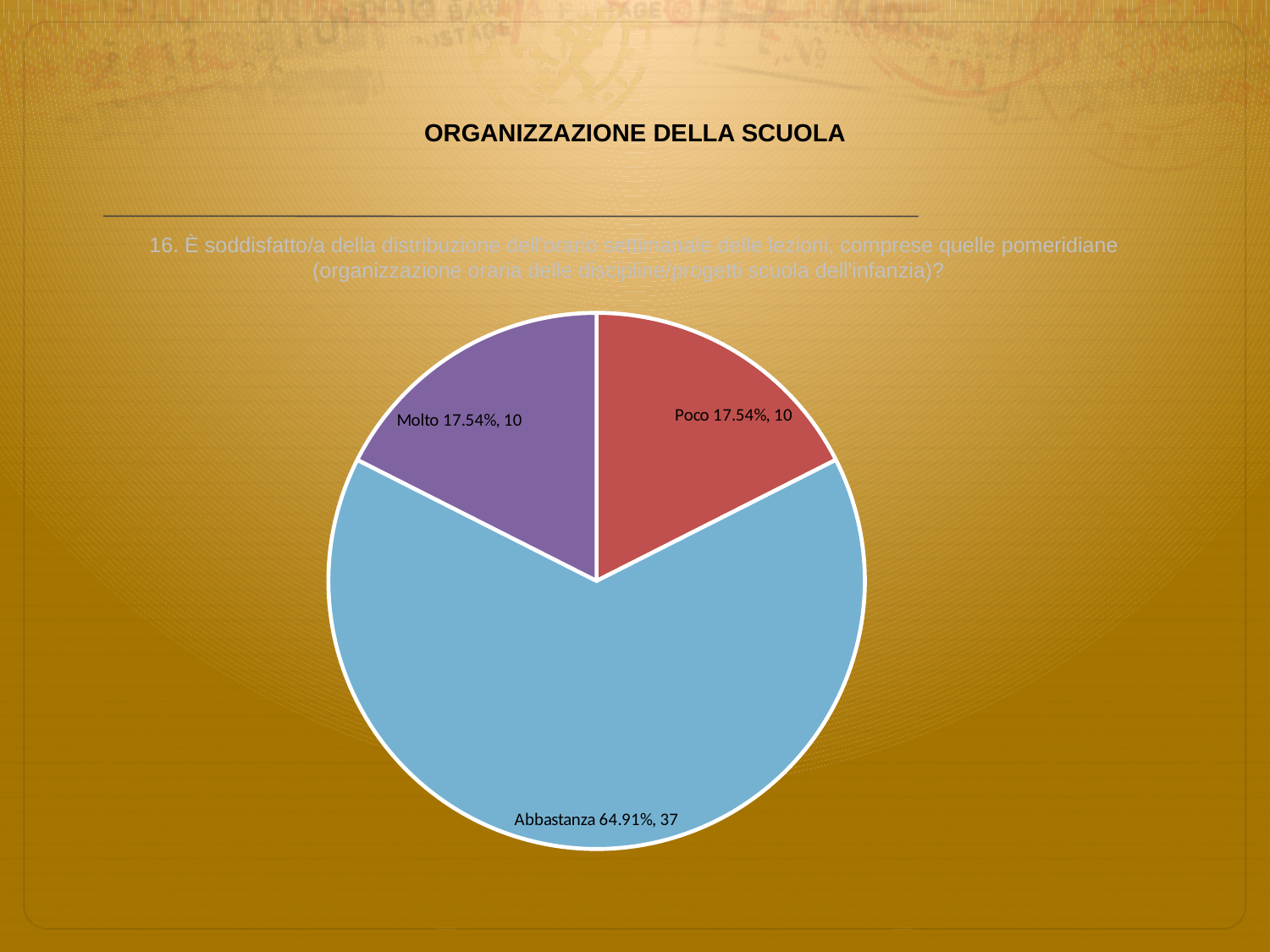
What count is shown for the Abbastanza slice? 37 What colour is the Abbastanza slice? light blue What count is shown for the Molto slice? 10 Which is larger, the Abbastanza slice or the Poco slice? Abbastanza What kind of chart is shown on the slide? pie chart What percentage is shown for the Abbastanza slice? 64.91% How many slices does the pie chart have? 3 What share of the pie does the Molto slice represent? 17.54% What is the difference between the counts for Abbastanza and Molto? 27 Which slice is the largest in the pie chart? Abbastanza What is the total count across all three slices? 57 What percentage is shown for the Poco slice? 17.54%